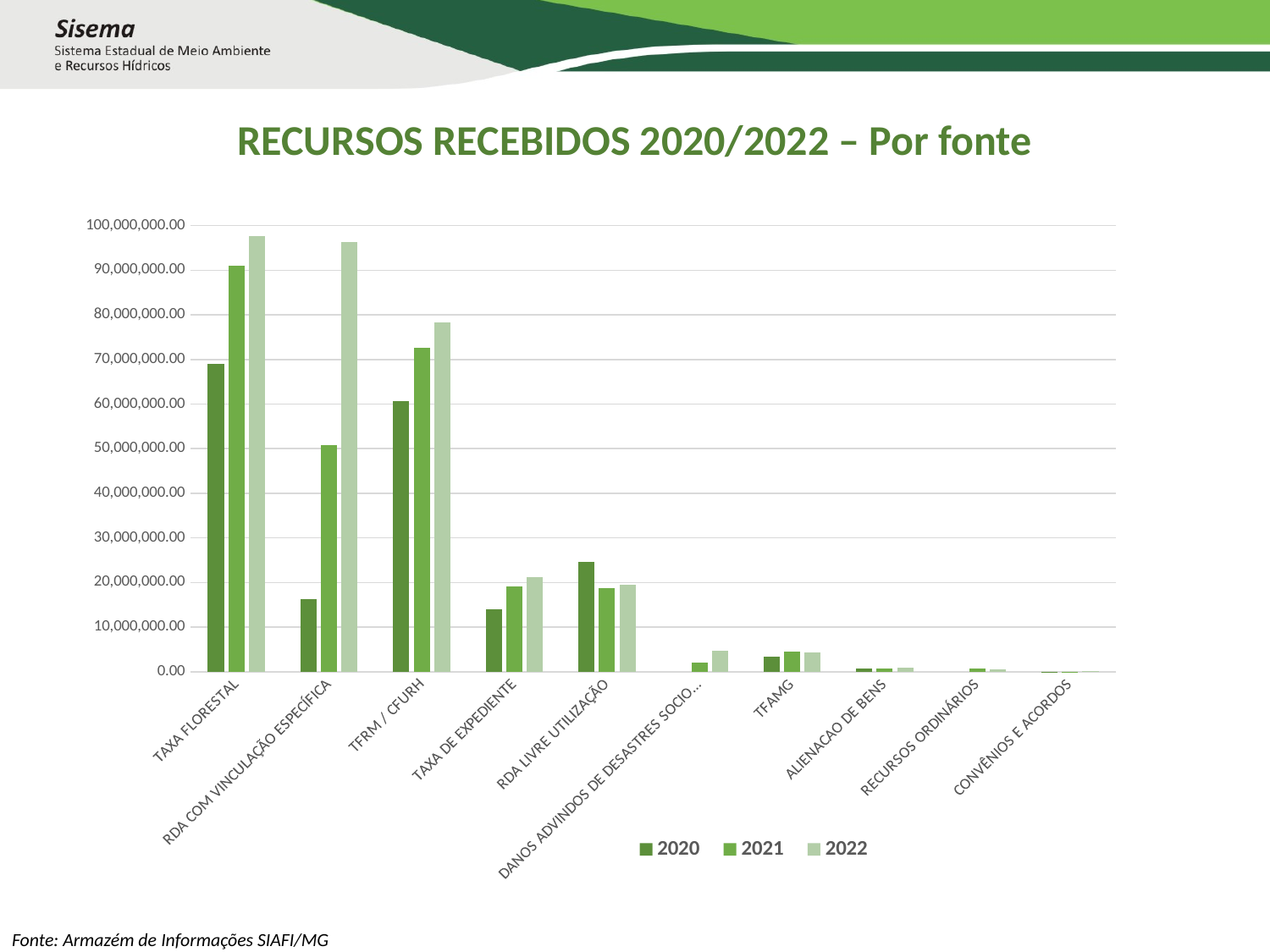
What are the entries in the chart legend? 2020, 2021, 2022 Which category has the highest value for 2020? TAXA FLORESTAL Is the 2021 value for TAXA FLORESTAL greater or less than 80,000,000.00? greater Which category has the highest value for 2021? TAXA FLORESTAL Which is larger for 2022: TFRM / CFURH or TAXA FLORESTAL? TAXA FLORESTAL How many series does the legend list? 3 How many categories are shown on the x axis? 10 Do the values for TAXA FLORESTAL rise or fall from 2020 to 2022? rise Which is larger for RDA LIVRE UTILIZAÇÃO: the 2020 value or the 2021 value? 2020 Is the 2020 value for TFRM / CFURH greater or less than 50,000,000.00? greater What kind of chart is shown on the slide? Bar chart Is the 2020 value for RDA COM VINCULAÇÃO ESPECÍFICA greater or less than 20,000,000.00? less